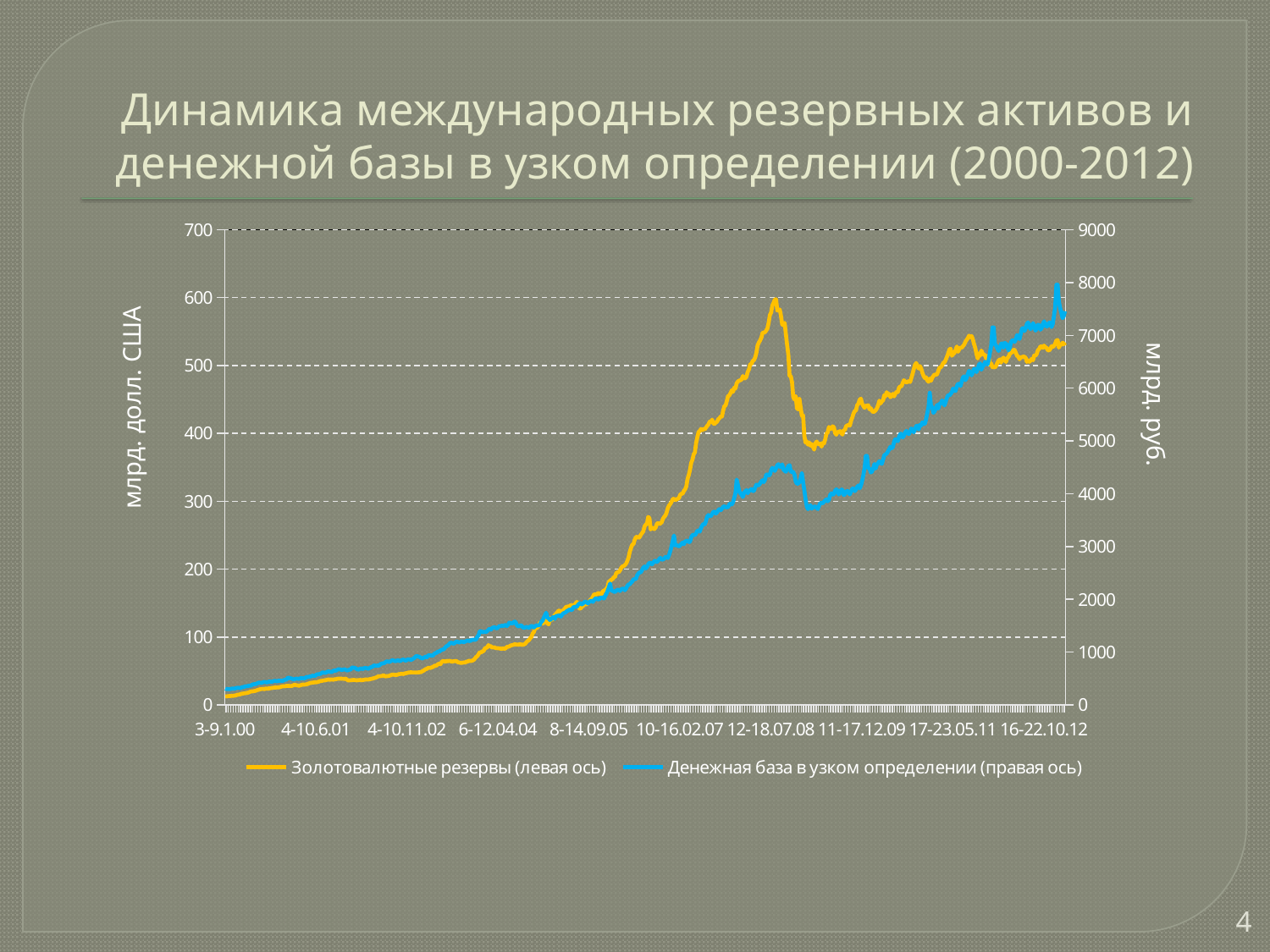
Is the value of 'Денежная база в узком определении (правая ось)' at the end of the period (16-22.10.12) greater or less than 7000 on the right axis? greater Is the value of 'Денежная база в узком определении (правая ось)' at the start of the period (3-9.1.00) greater or less than 1000 on the right axis? less How many series does the legend list? 2 Is the peak value of 'Золотовалютные резервы (левая ось)' in 2008 greater or less than 500 on the left axis? greater What kind of chart is shown on the slide? line chart Overall, do the values of the series 'Денежная база в узком определении (правая ось)' rise or fall along the x axis? rise Overall, do the values of the series 'Золотовалютные резервы (левая ось)' rise or fall from 2000 to 2012? rise What is the label of the left vertical axis? млрд. долл. США What is the maximum value shown on the right vertical axis? 9000 What is the title of the chart? Динамика международных резервных активов и денежной базы в узком определении (2000-2012)